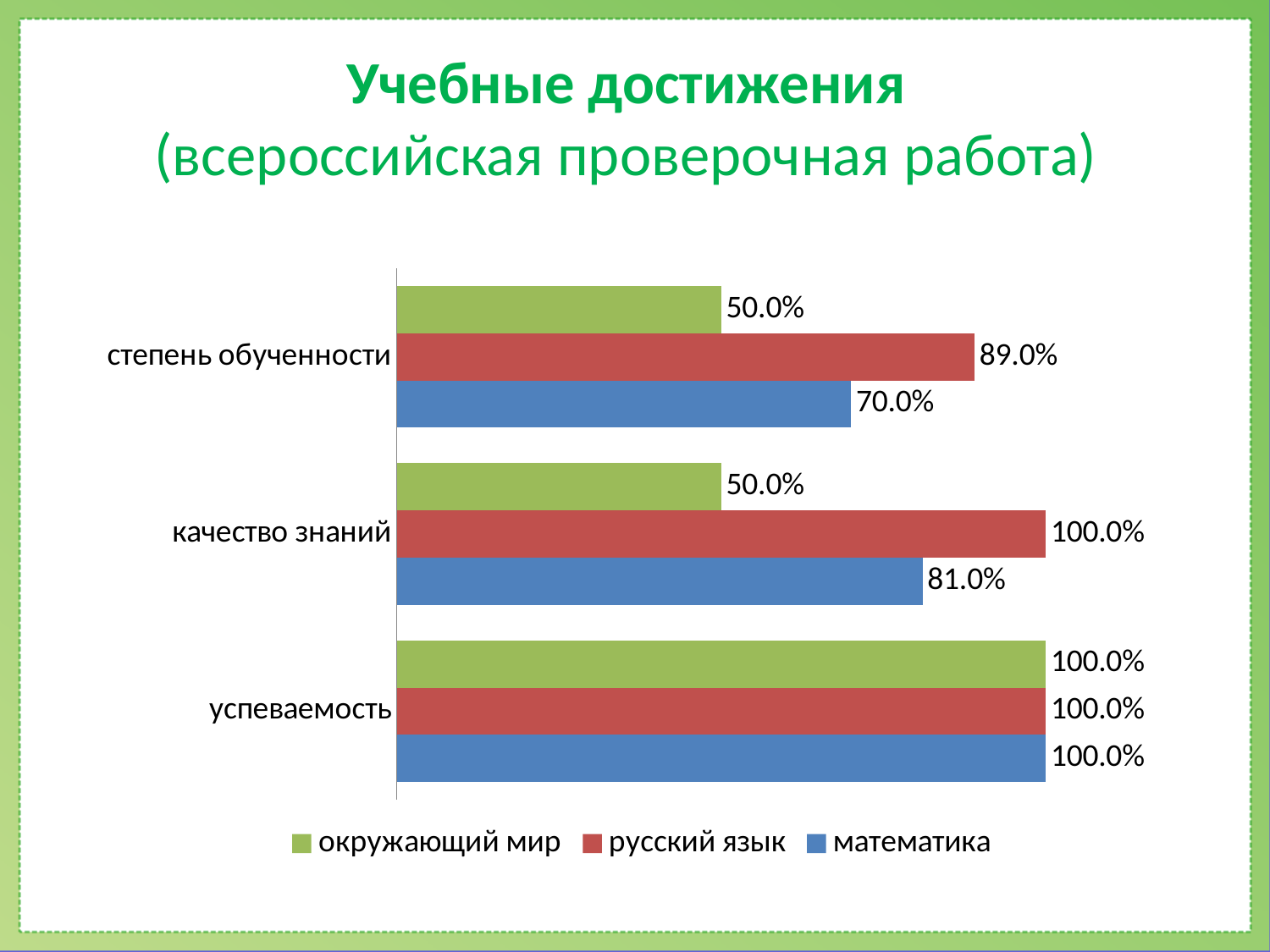
Which is larger in the качество знаний category: математика or окружающий мир? математика Which series has the highest value in the степень обученности category? русский язык How many categories are shown on the chart? 3 Which colour represents русский язык in the chart? red What is the value for математика in the степень обученности category? 70.0% Which series has the lowest value in the качество знаний category? окружающий мир How many series does the legend list? 3 What is the value for окружающий мир in the степень обученности category? 50.0% What is the value for русский язык in the качество знаний category? 100.0% What is the difference between the русский язык and математика values in the степень обученности category? 19.0% What kind of chart is shown on the slide? bar chart What is the value for математика in the качество знаний category? 81.0%